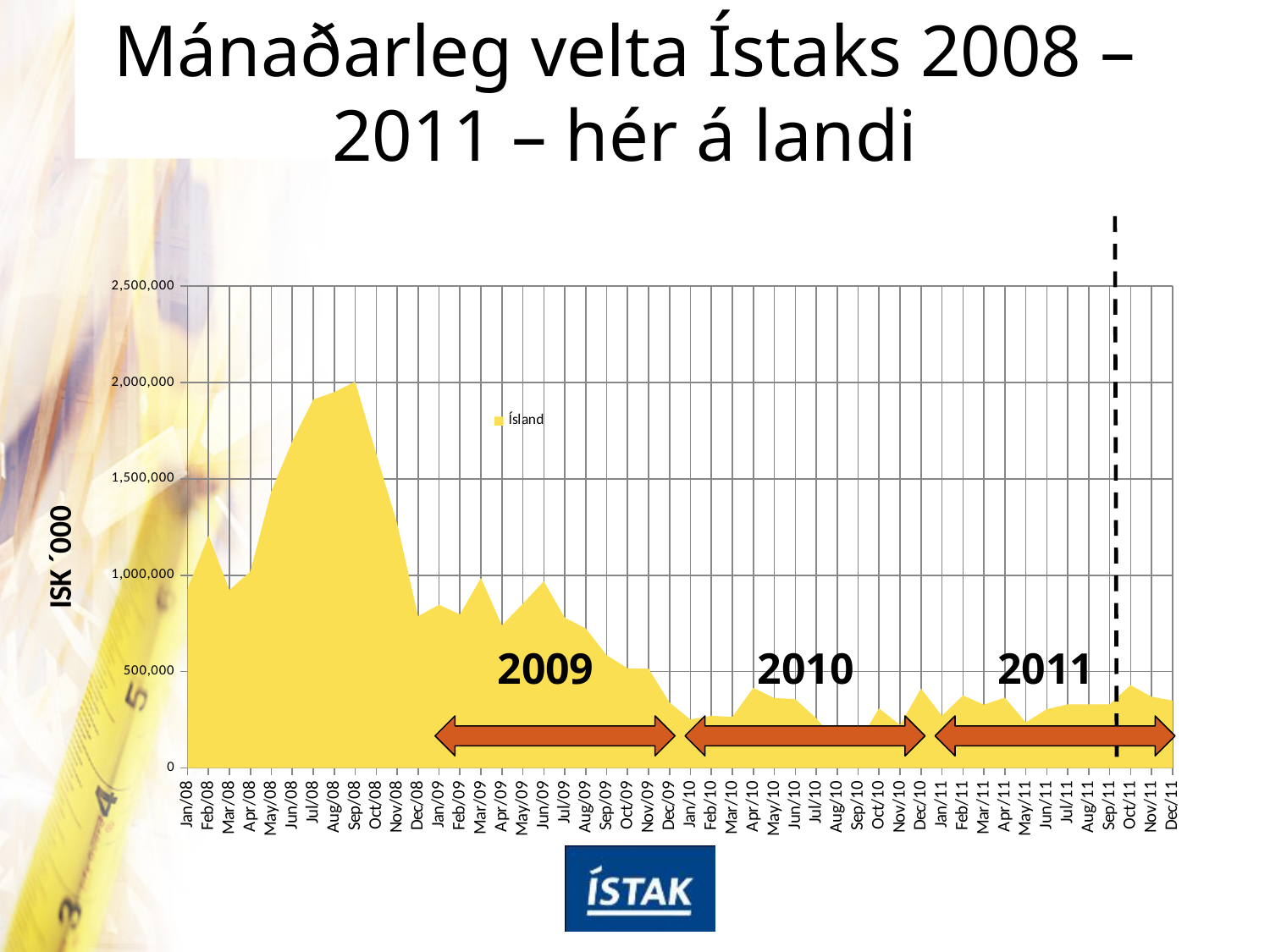
What is the name of the series shown in the legend? Ísland Which month has the highest value? Sep/08 What kind of chart is shown on the slide? area chart Is the value for Sep/08 greater or less than 1,500,000? greater Is the value for Apr/10 greater or less than 500,000? less Is the value for Feb/08 greater or less than 1,000,000? greater What is the label on the y axis? ISK ´000 How many series does the legend list? 1 How many monthly data points are plotted along the x axis? 48 Which is larger, the value for Feb/08 or the value for Dec/11? Feb/08 Do the values generally rise or fall from Sep/08 to Dec/09? fall